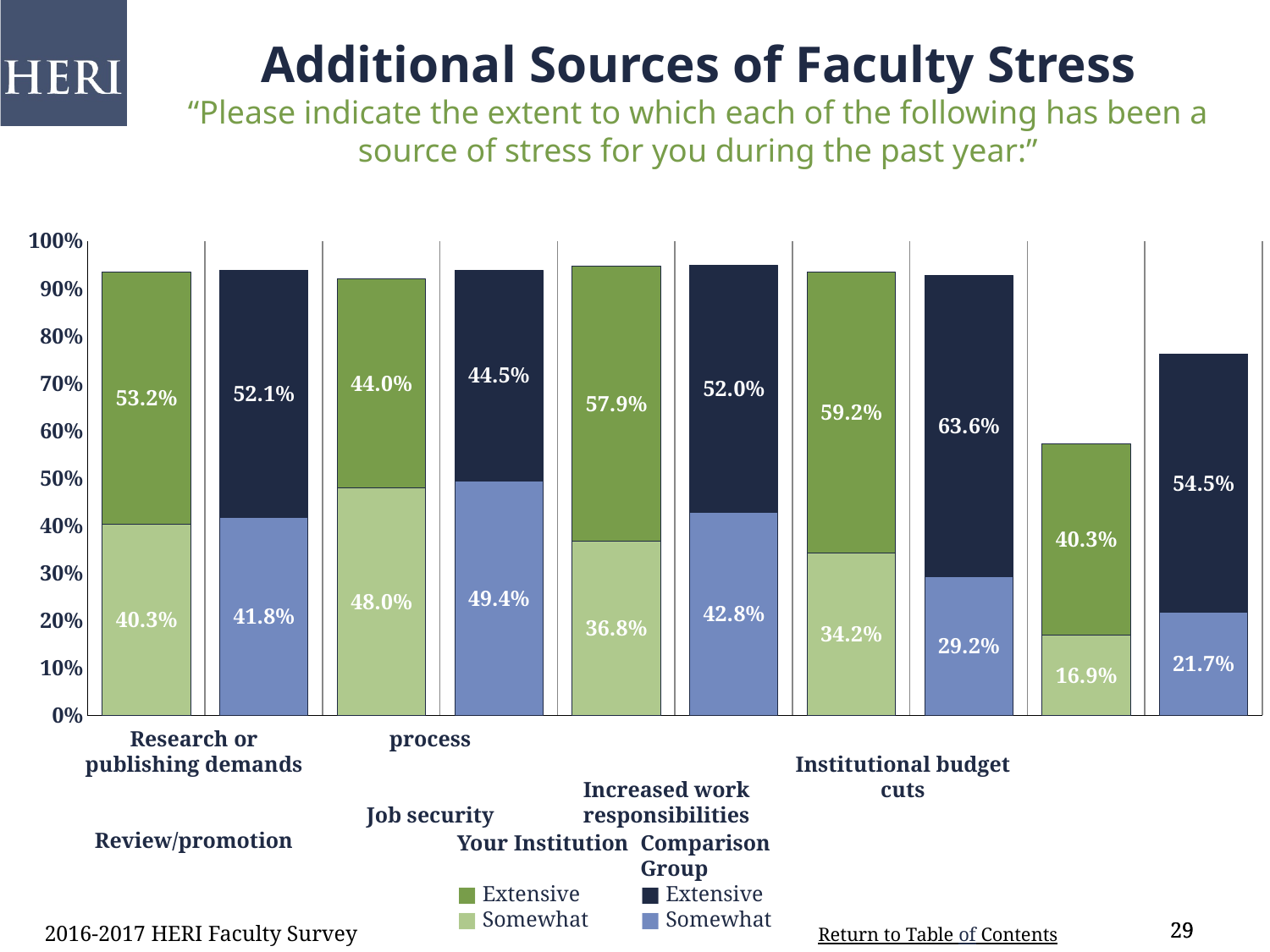
Which stress source has the highest extensive percentage for the Comparison Group? Increased work responsibilities How many stress sources (categories) are shown on the chart? 5 What is the difference between the Comparison Group's and Your Institution's extensive percentages for 'Job security'? 5.9% What is the total (somewhat plus extensive) for the Comparison Group on 'Job security'? 94.8% Which has the larger extensive percentage for 'Increased work responsibilities': Your Institution or the Comparison Group? Comparison Group What is the total (somewhat plus extensive) for Your Institution on 'Job security'? 94.7% What type of chart is shown on the slide? Stacked bar chart What percentage of the Comparison Group reported 'Institutional budget cuts' as an extensive source of stress? 54.5% What percentage of Your Institution faculty reported 'Research or publishing demands' as an extensive source of stress? 53.2% Which stress source has the lowest somewhat percentage for Your Institution? Institutional budget cuts How many entries does the legend list? 4 What percentage of the Comparison Group reported 'Job security' as a somewhat source of stress? 42.8%